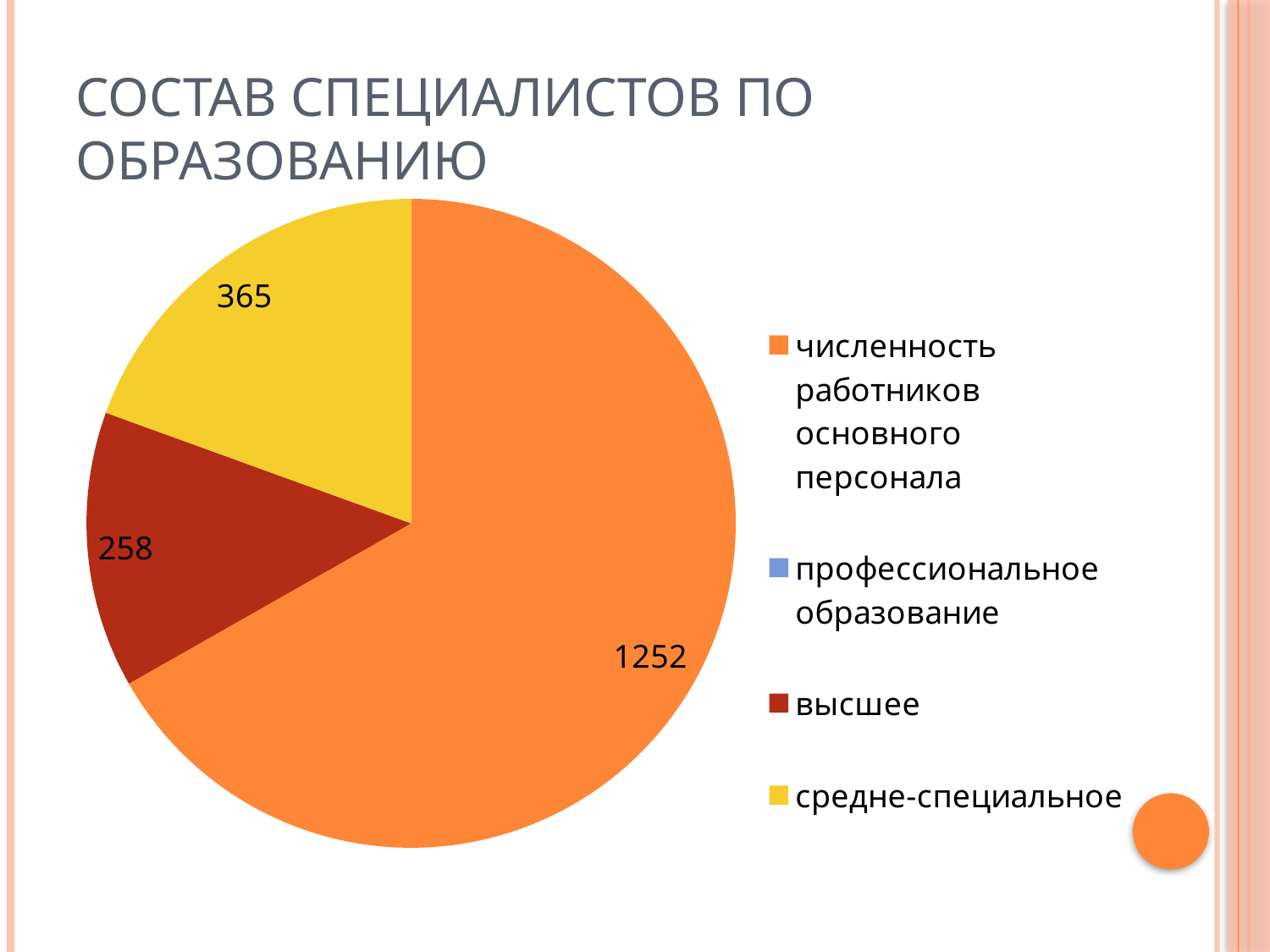
Which is larger, the value for 'высшее' or the value for 'средне-специальное'? средне-специальное What is the difference between the values for 'средне-специальное' and 'высшее'? 107 What is the value for the slice labelled 'численность работников основного персонала'? 1252 What is the title of the slide? СОСТАВ СПЕЦИАЛИСТОВ ПО ОБРАЗОВАНИЮ Which category has the largest slice of the pie? численность работников основного персонала What is the difference between the values for 'численность работников основного персонала' and 'средне-специальное'? 887 What type of chart is shown on the slide? pie chart How many entries does the legend list? 4 What is the value for the slice labelled 'средне-специальное'? 365 Which labelled slice of the pie is the smallest? высшее How many slices with data labels are shown in the pie? 3 What is the value for the slice labelled 'высшее'? 258